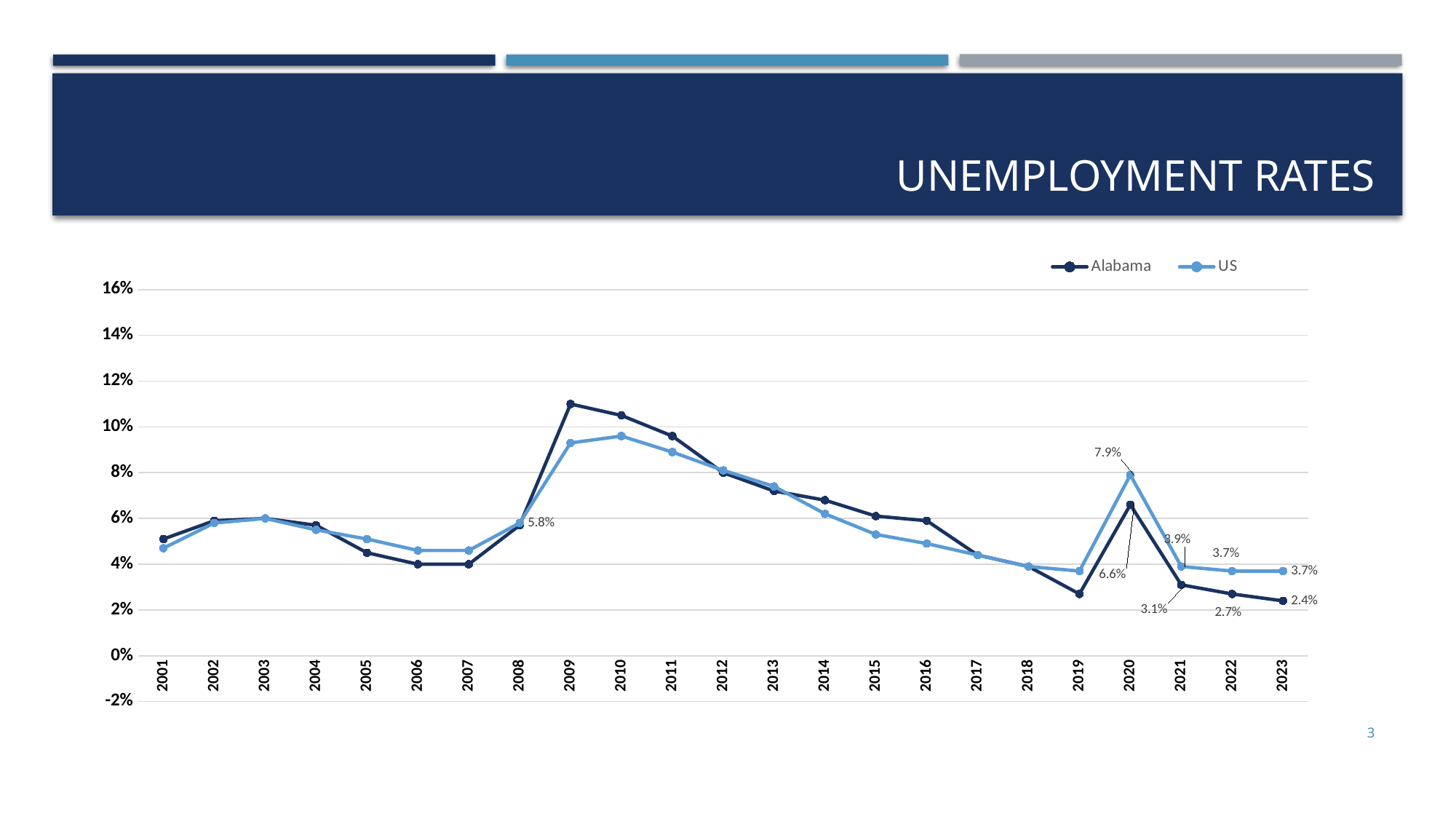
What was the US unemployment rate in 2020? 7.9% How many series does the legend list? 2 In which year did Alabama's unemployment rate reach its highest point? 2009 In 2009, which had the higher unemployment rate, Alabama or the US? Alabama What was Alabama's unemployment rate in 2023? 2.4% Is Alabama's unemployment rate in 2009 greater or less than 10%? greater What kind of chart is shown on the slide? Line chart What was Alabama's unemployment rate in 2021? 3.1% In 2020, how much higher was the US unemployment rate than Alabama's? 1.3 percentage points What was the US unemployment rate in 2023? 3.7% What was Alabama's unemployment rate in 2020? 6.6% In 2023, what is the difference between the US and Alabama unemployment rates? 1.3 percentage points